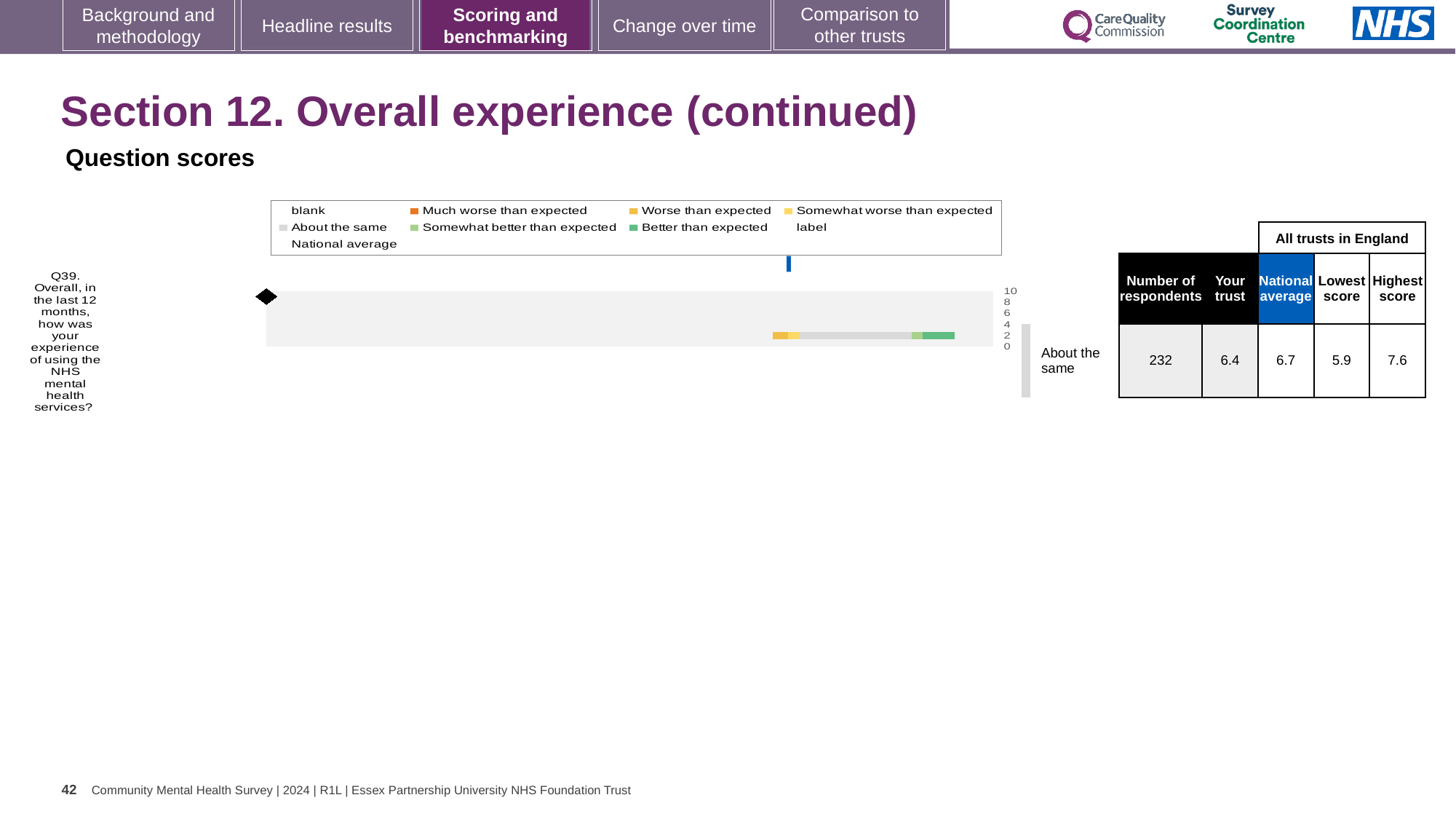
What is the highest score among all trusts in England for Q39? 7.6 What is the national average score for Q39? 6.7 What is the highest value shown on the chart's score axis? 10 How many survey questions are plotted in the chart on this slide? 1 By how much does the national average exceed the 'Your trust' score for Q39? 0.3 What kind of chart is shown on the slide for Q39? bar chart What is the 'Your trust' score for Q39 (Overall, in the last 12 months, how was your experience of using the NHS mental health services?)? 6.4 How many respondents answered Q39? 232 Which benchmarking category is the trust's result for Q39 labelled as? About the same What is the lowest score among all trusts in England for Q39? 5.9 For Q39, which is larger: the 'Your trust' score or the national average? National average What is the difference between the highest score and the lowest score for Q39? 1.7